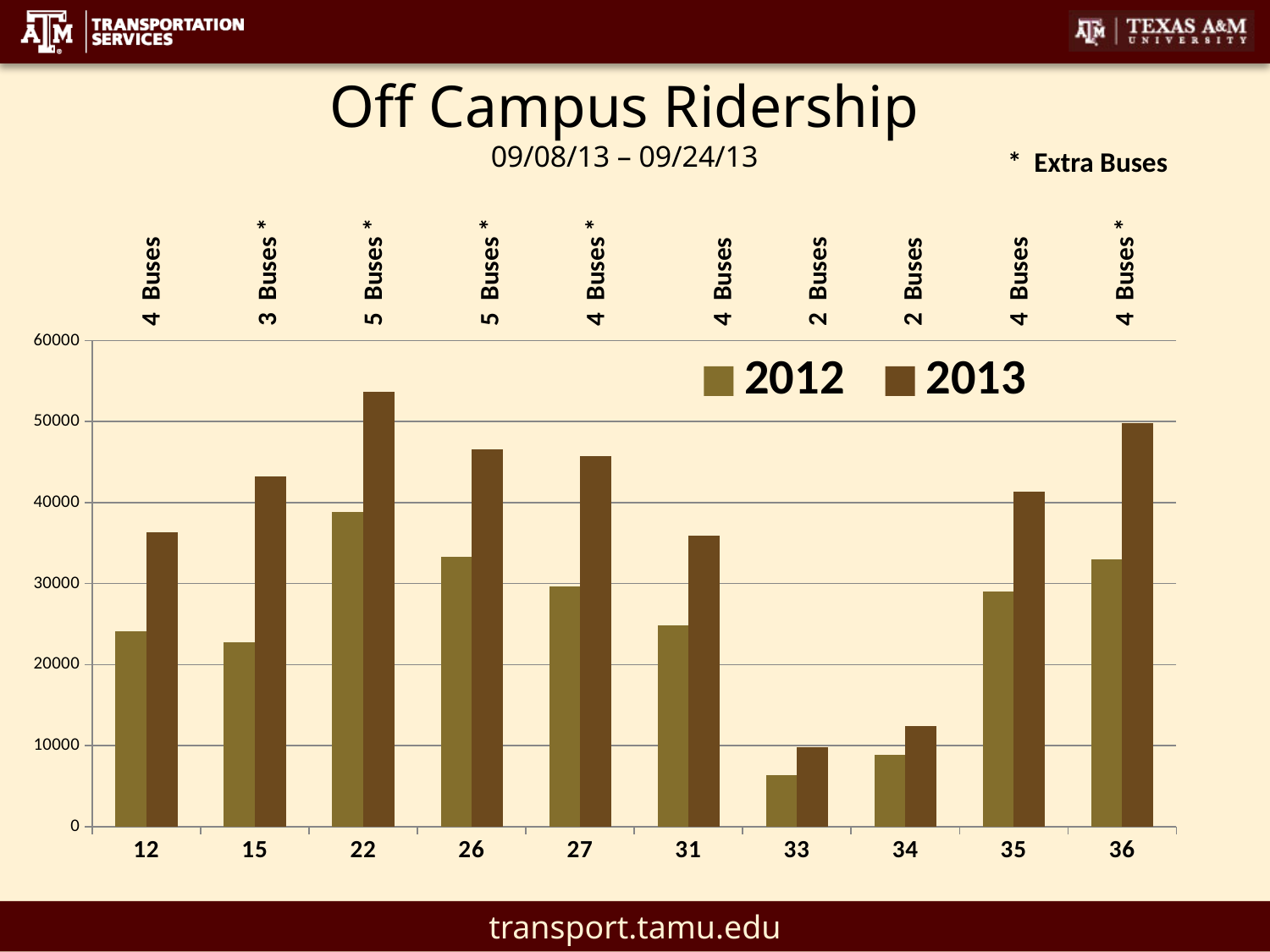
How many route categories are shown on the x axis? 10 Is the 2013 value for route 22 greater or less than 50000? greater How many series does the legend list? 2 Is the 2013 value for route 12 greater or less than 30000? greater Which route has the lowest 2012 ridership? 33 What is the title of the chart? Off Campus Ridership What kind of chart is shown on the slide? bar chart Which is larger, the 2012 value for route 22 or the 2012 value for route 36? route 22 Which is larger, the 2013 value for route 35 or the 2013 value for route 12? route 35 Which route has the lowest 2013 ridership? 33 Is the 2012 value for route 33 greater or less than 10000? less Which route has the highest 2013 ridership? 22